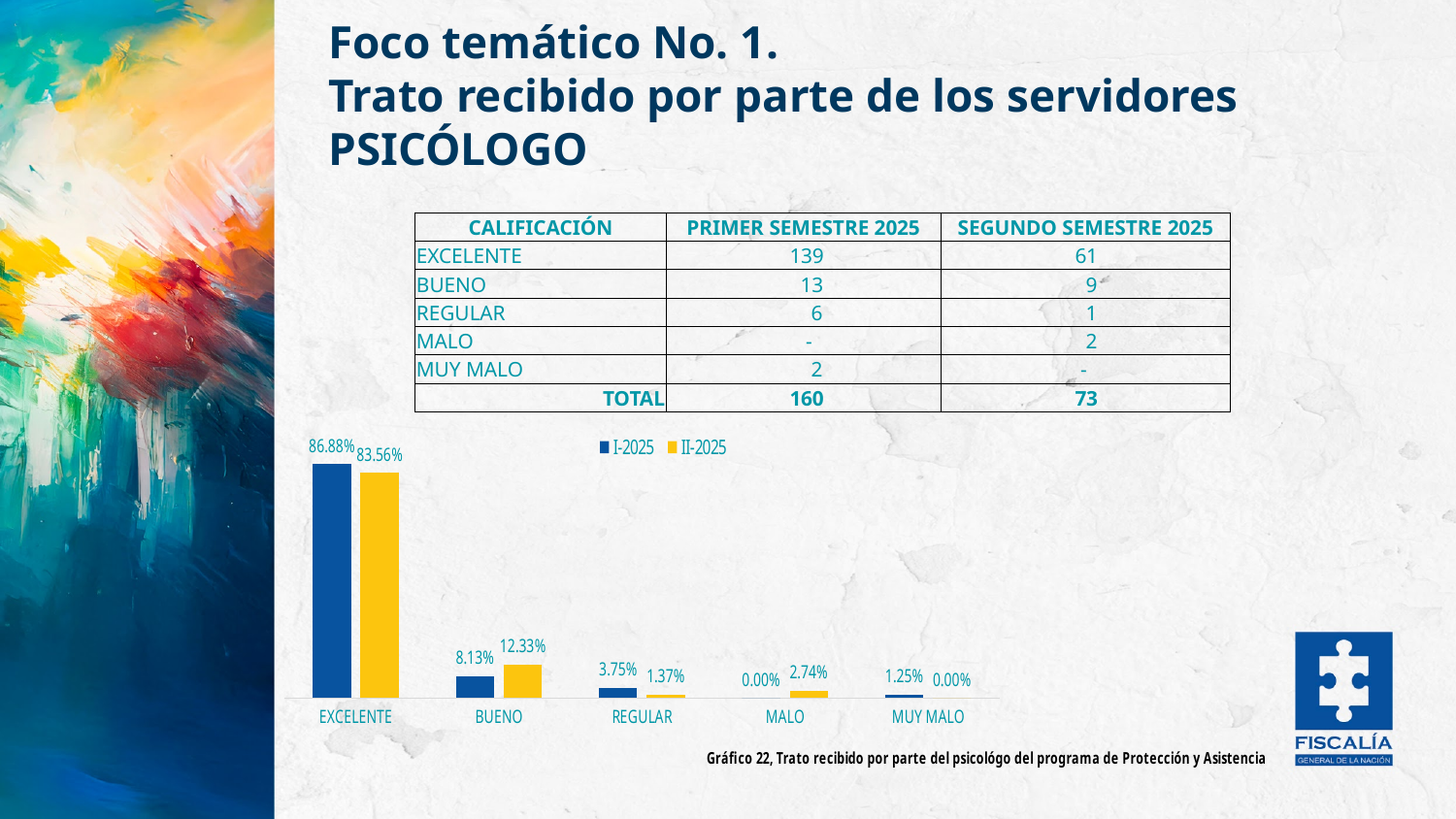
Which category has the lowest value in the II-2025 series? MUY MALO Which category has the highest value in the I-2025 series? EXCELENTE What is the difference between the I-2025 and II-2025 values for BUENO? 4.20% What is the value for EXCELENTE in the II-2025 series? 83.56% What is the value for MALO in the II-2025 series? 2.74% What kind of chart is shown on the slide? bar chart What is the value for EXCELENTE in the I-2025 series? 86.88% What is the value for BUENO in the II-2025 series? 12.33% Which series has the larger value for REGULAR, I-2025 or II-2025? I-2025 How many series does the chart legend list? 2 How many categories are shown on the x axis of the chart? 5 What is the value for MUY MALO in the I-2025 series? 1.25%